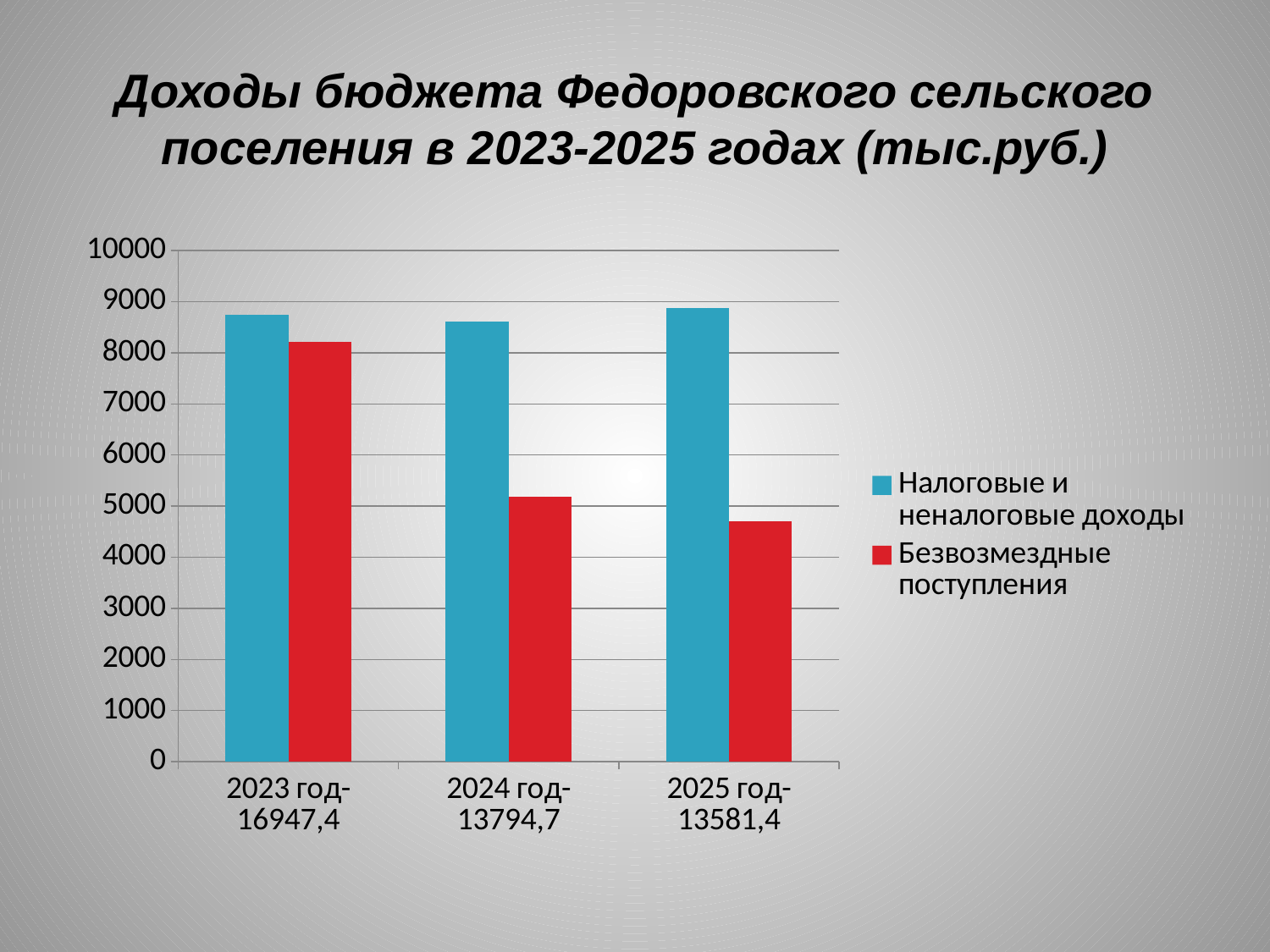
What total budget income is printed in the x-axis label for 2023? 16947,4 In which year is the value for Безвозмездные поступления the highest? 2023 In 2024, which is larger: Налоговые и неналоговые доходы or Безвозмездные поступления? Налоговые и неналоговые доходы What kind of chart is shown on the slide? Bar chart Do the values for Безвозмездные поступления rise or fall from 2023 to 2025? Fall Is the value for Безвозмездные поступления in 2025 greater or less than 5000? less How many year categories are shown on the x axis? 3 Is the value for Налоговые и неналоговые доходы in 2024 greater or less than 8000? greater In which year is the value for Безвозмездные поступления the lowest? 2025 How many series does the legend list? 2 Which colour represents Безвозмездные поступления in the legend? Red What total budget income is printed in the x-axis label for 2025? 13581,4